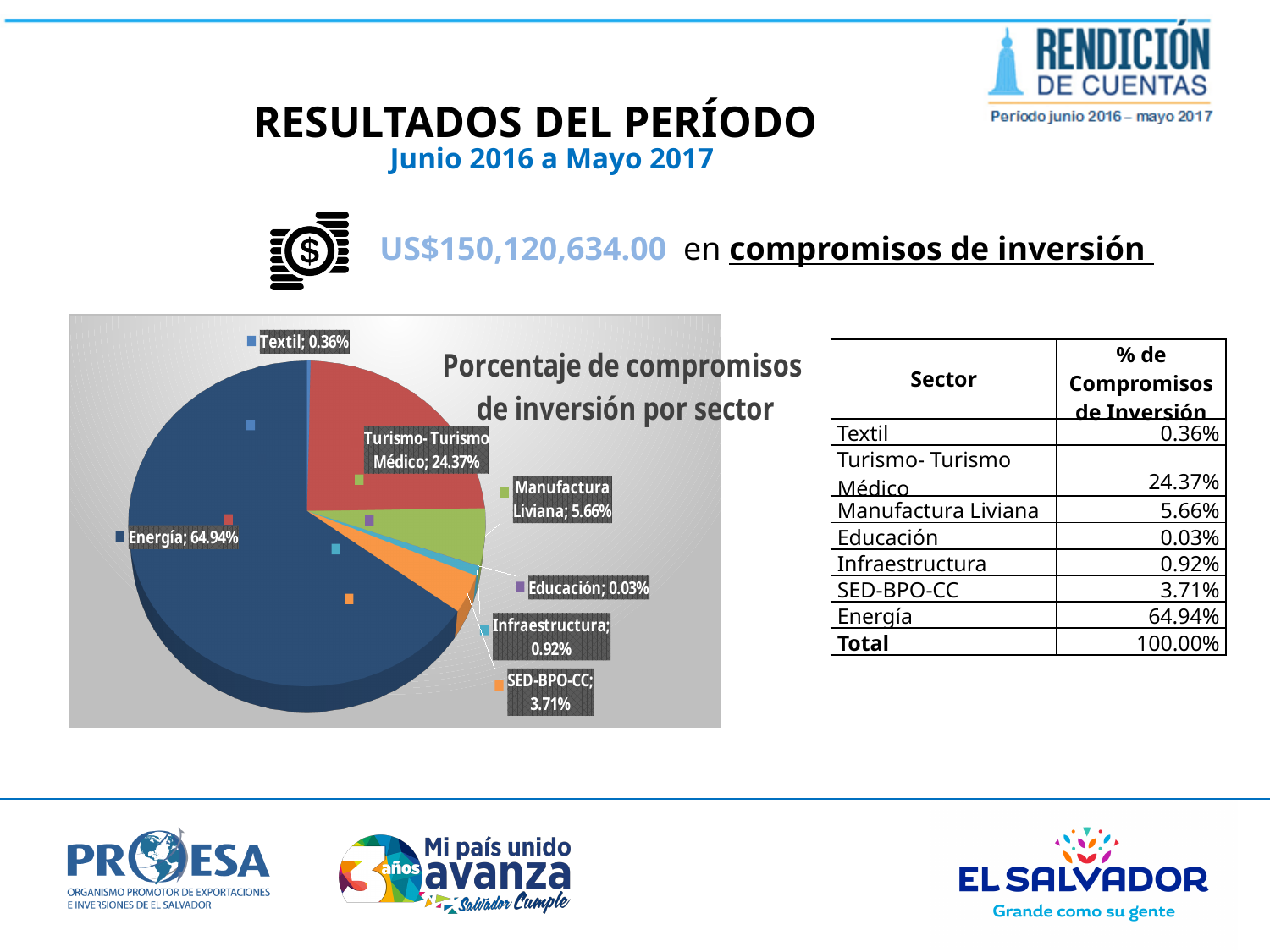
What is the value shown for Turismo- Turismo Médico in the pie chart? 24.37% What kind of chart is shown on the slide? Pie chart What is the combined share of Textil and Educación in the pie chart? 0.39% What is the value shown for Manufactura Liviana in the pie chart? 5.66% What is the difference in percentage points between Energía and Turismo- Turismo Médico in the pie chart? 40.57 Which sector has the smallest share in the pie chart? Educación What is the value shown for SED-BPO-CC in the pie chart? 3.71% What percentage of investment commitments does the Energía sector represent in the pie chart? 64.94% Which has a larger share in the pie chart, Infraestructura or Textil? Infraestructura What is the title of the pie chart? Porcentaje de compromisos de inversión por sector How many sectors are shown in the pie chart? 7 Which sector has the largest share in the pie chart? Energía